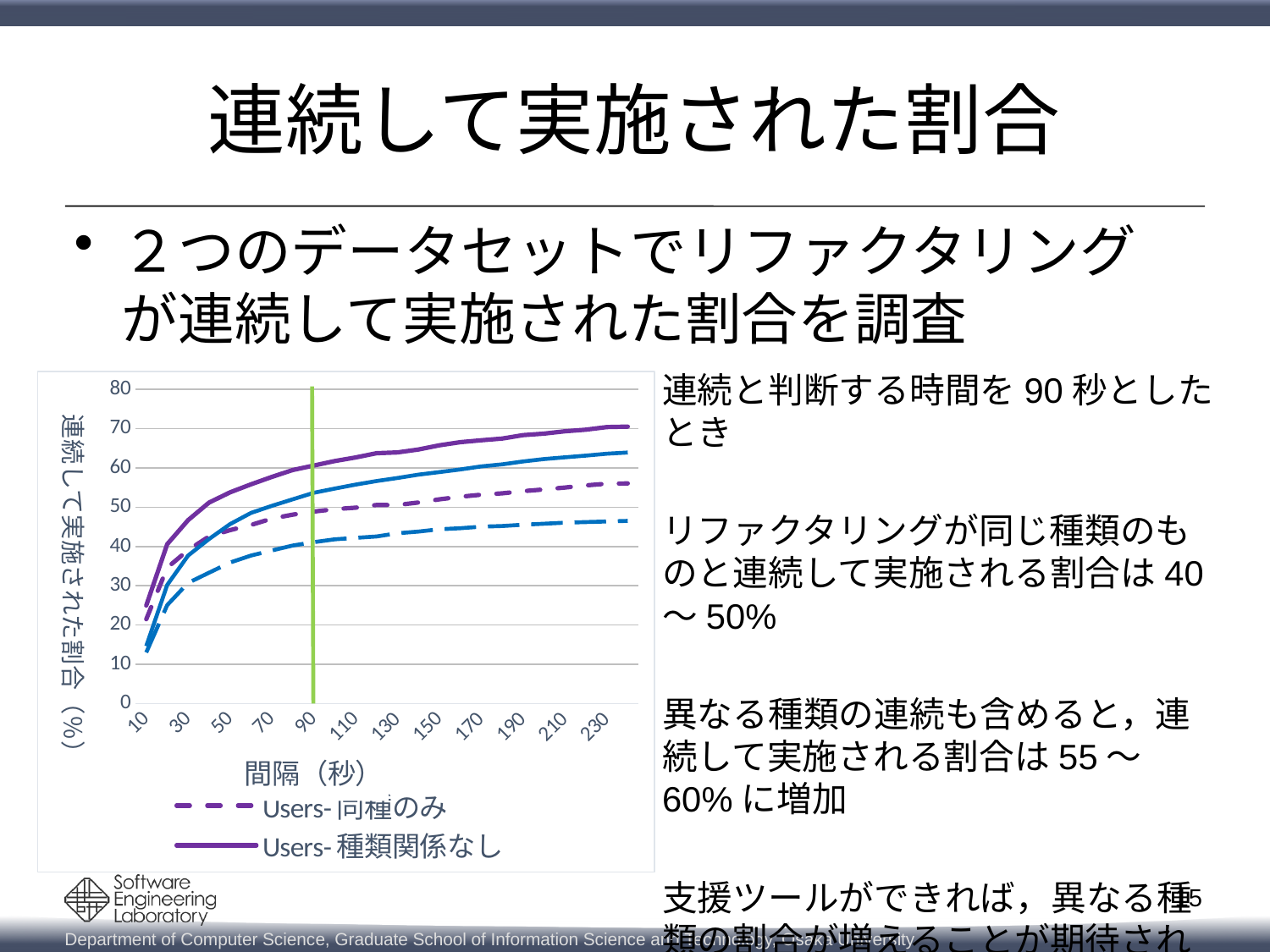
Is the value for Users-種類関係なし at 10 seconds greater or less than 30? less What is the title of the x axis of the chart? 間隔（秒） Do the values for Users-同種のみ rise or fall as the interval increases along the x axis? rise Is the value for Users-同種のみ at 10 seconds greater or less than 30? less At 230 seconds, which is larger: Users-種類関係なし or Users-同種のみ? Users-種類関係なし Do the values for Users-種類関係なし rise or fall as the interval (間隔) increases along the x axis? rise At which x-axis value is the vertical green line drawn on the chart? 90 What kind of chart is shown on the slide? line chart How many series does the chart's legend list? 2 Is the value for Users-種類関係なし at 230 seconds greater or less than 60? greater How many tick labels are shown on the x axis of the chart? 12